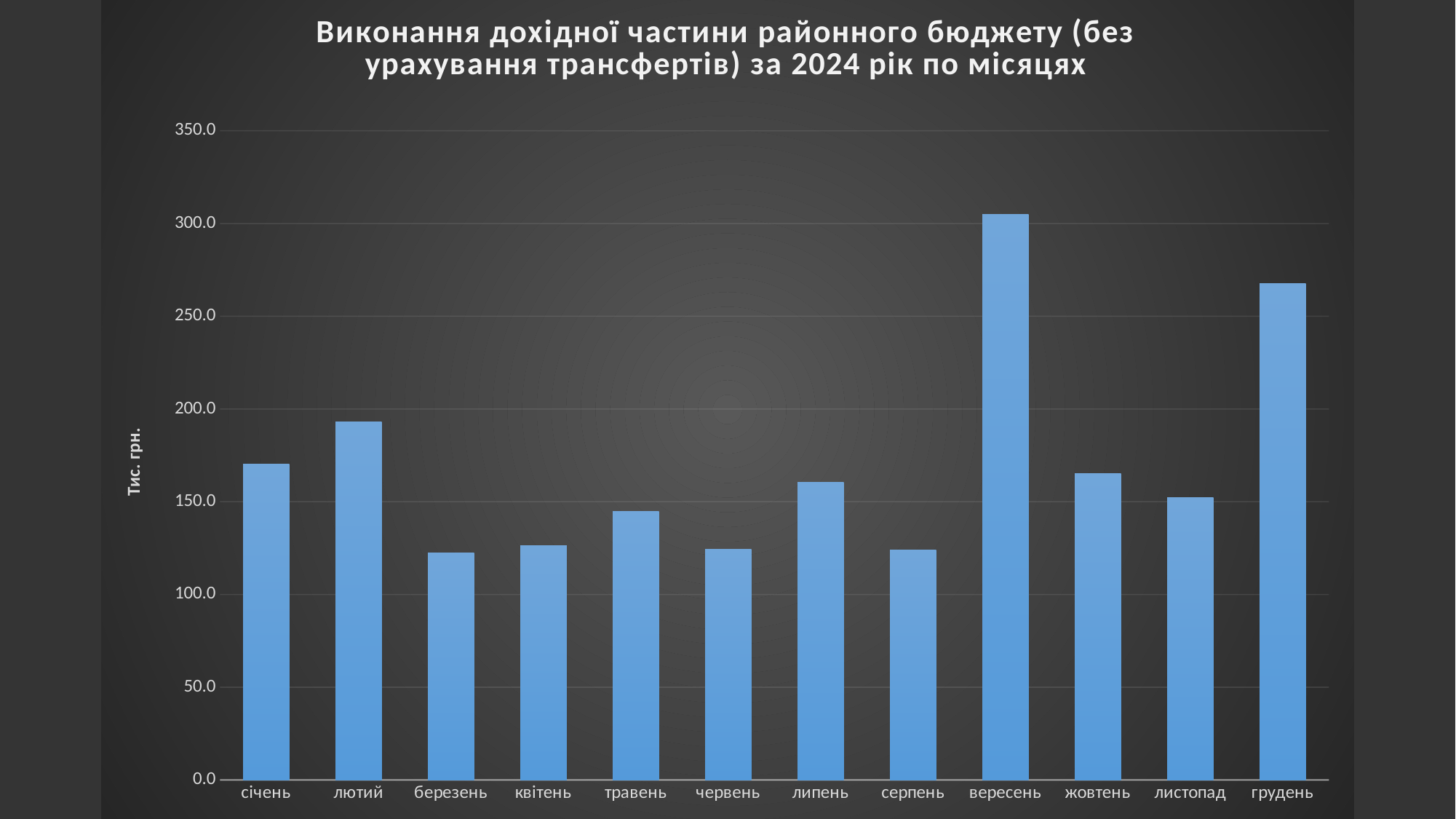
Is the value for лютий greater or less than 200? less Which is larger, the value for лютий or the value for січень? лютий Which is larger, the value for вересень or the value for грудень? вересень How many months are shown on the x axis of the chart? 12 Is the value for березень greater or less than 150? less Is the value for вересень greater or less than 250? greater What kind of chart is shown on the slide? bar chart What is the label on the vertical axis of the chart? Тис. грн. Which month has the highest value in the chart? вересень Which is larger, the value for травень or the value for квітень? травень